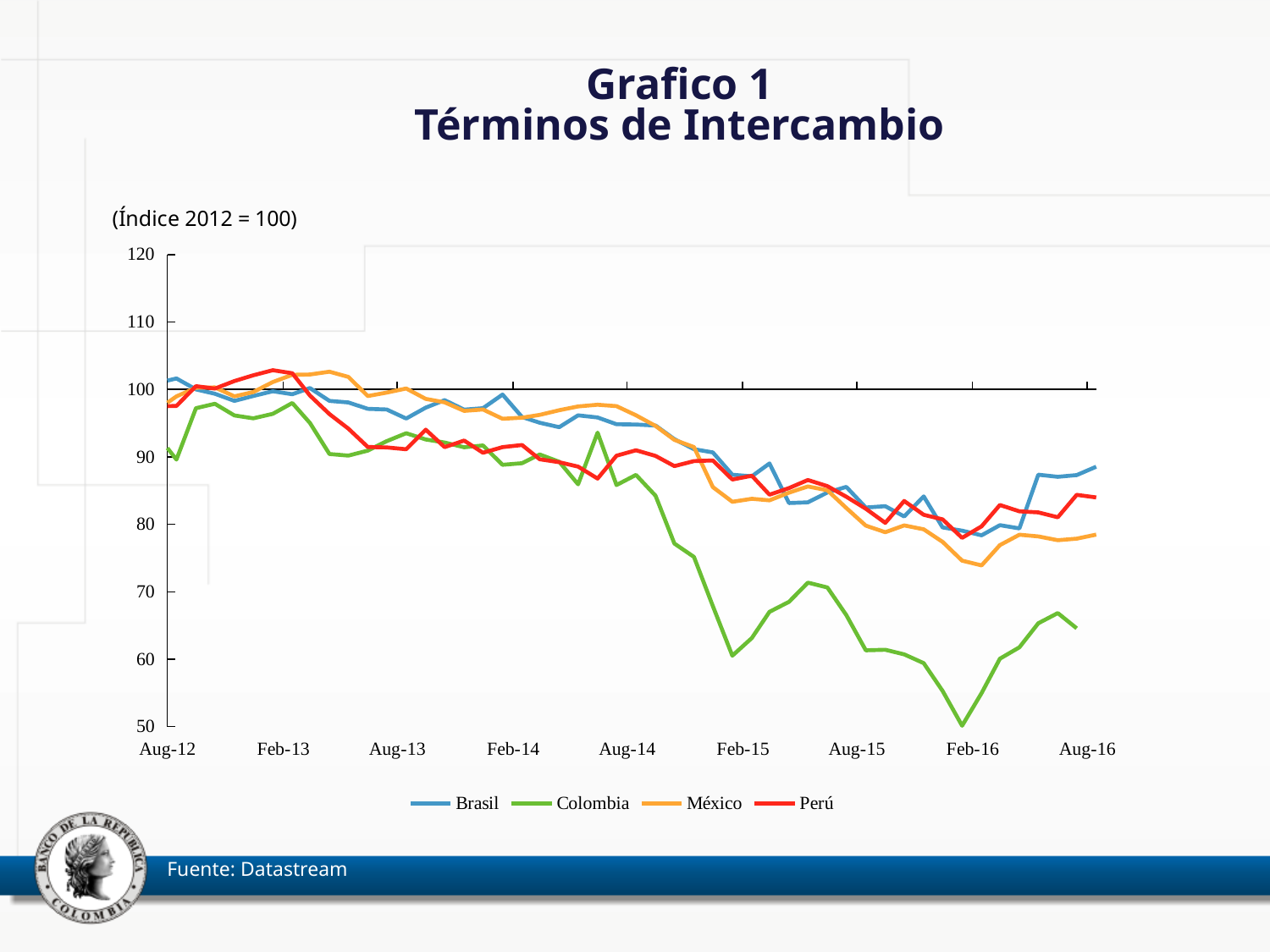
Is the value for Brasil at Aug-16 greater or less than 80? greater Does the Colombia series rise or fall overall from Aug-12 to Aug-16? fall What kind of chart is shown on the slide? line chart Is the value for Colombia at Feb-16 greater or less than 60? less Which countries are listed in the chart legend? Brasil, Colombia, México, Perú Which series reaches the lowest point anywhere on the chart? Colombia Is the value for México at Feb-16 greater or less than 80? less At Feb-15, which series is higher, Brasil or Colombia? Brasil How many series does the legend list? 4 What is the base of the index used in the chart, as stated on the slide? Índice 2012 = 100